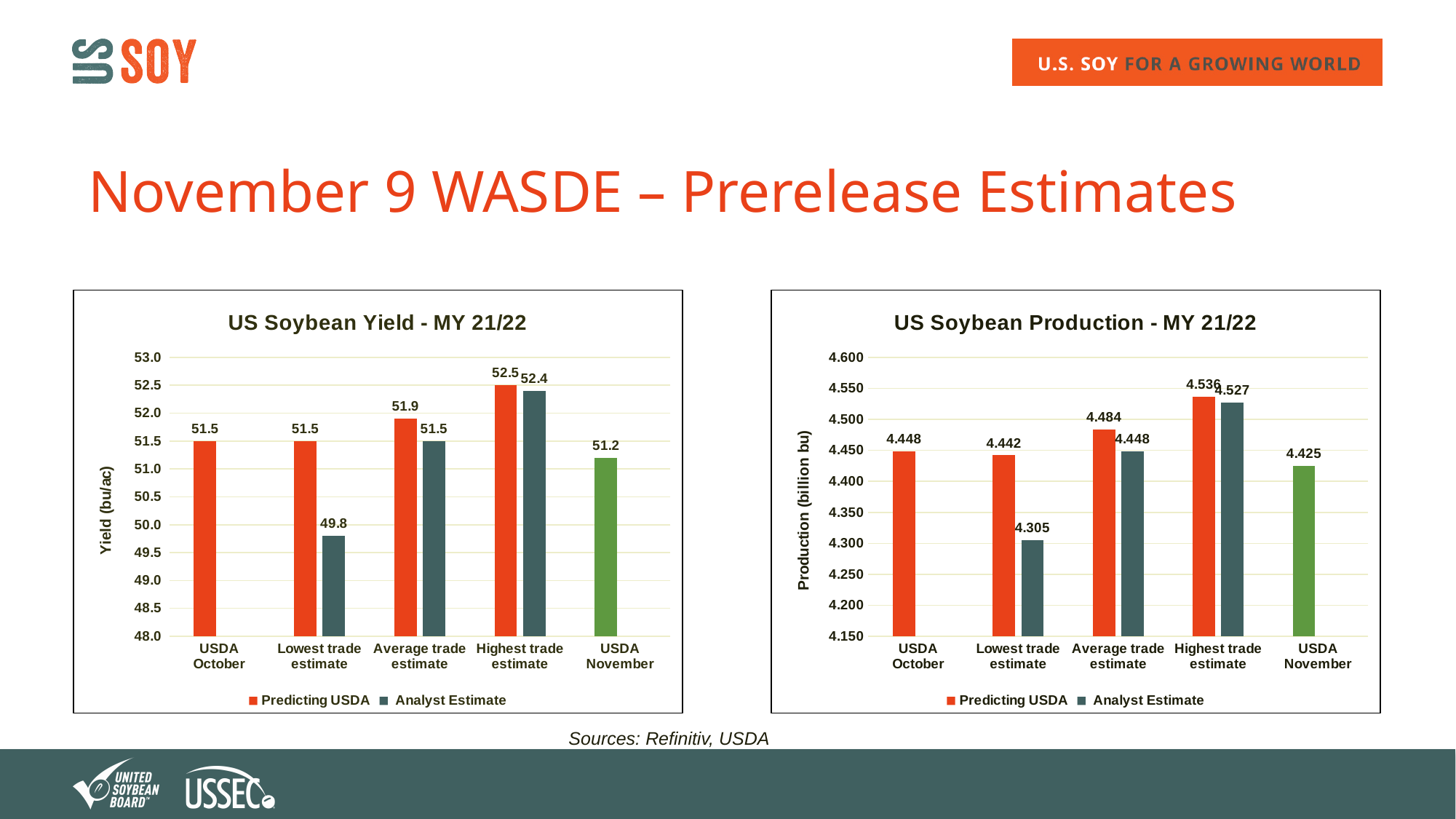
In the US Soybean Yield - MY 21/22 chart, what is the Predicting USDA value for USDA October? 51.5 In the US Soybean Yield - MY 21/22 chart, which category has the highest Predicting USDA value? Highest trade estimate In the US Soybean Production - MY 21/22 chart, what is the Predicting USDA value for the Highest trade estimate? 4.536 In the US Soybean Production - MY 21/22 chart, what is the value shown for USDA November? 4.425 In the US Soybean Production - MY 21/22 chart, what is the Analyst Estimate value for the Lowest trade estimate? 4.305 In the US Soybean Yield - MY 21/22 chart, what is the difference between the Predicting USDA and Analyst Estimate values for the Average trade estimate? 0.4 In the US Soybean Yield - MY 21/22 chart, how many series does the legend list? 2 What kind of chart is the US Soybean Production - MY 21/22 chart? Bar chart In the US Soybean Yield - MY 21/22 chart, what is the value shown for USDA November? 51.2 In the US Soybean Production - MY 21/22 chart, which is larger: the Predicting USDA value for USDA October or the value for USDA November? USDA October In the US Soybean Yield - MY 21/22 chart, what is the Analyst Estimate value for the Lowest trade estimate? 49.8 In the US Soybean Production - MY 21/22 chart, what is the difference between the Predicting USDA and Analyst Estimate values for the Highest trade estimate? 0.009